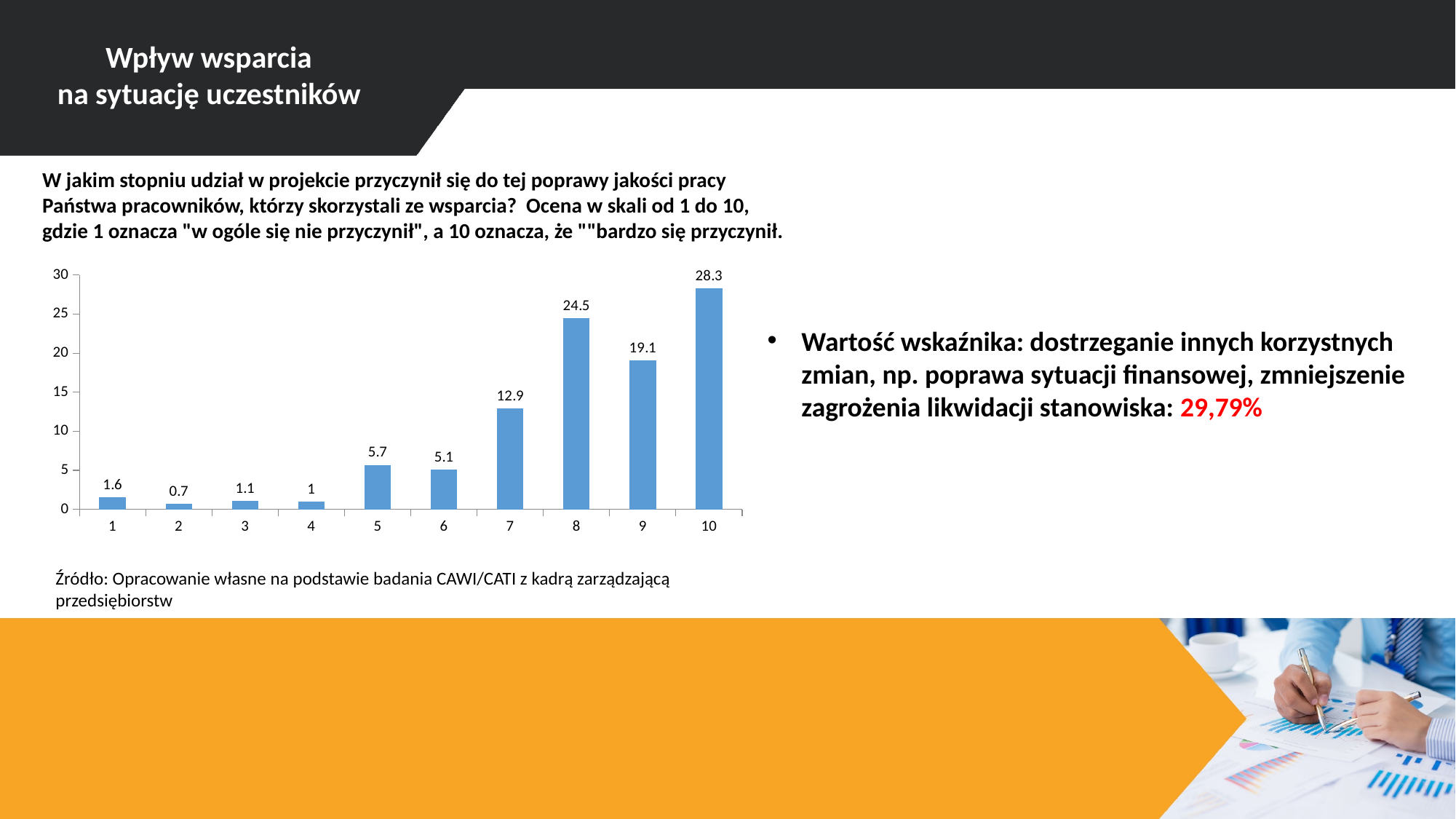
Which is larger, the value for rating 5 or rating 6? 5 Is the value for rating 9 greater or less than 20? less What is the value for rating 7? 12.9 Which rating has the lowest value? 2 What is the value for rating 10? 28.3 What is the highest tick value shown on the y axis? 30 Which rating has the highest value? 10 What kind of chart is shown on the slide? bar chart How many rating categories are shown on the x axis? 10 Do the values generally rise or fall from rating 1 to rating 10? rise What is the difference between the values for rating 10 and rating 8? 3.8 What is the value for rating 2? 0.7